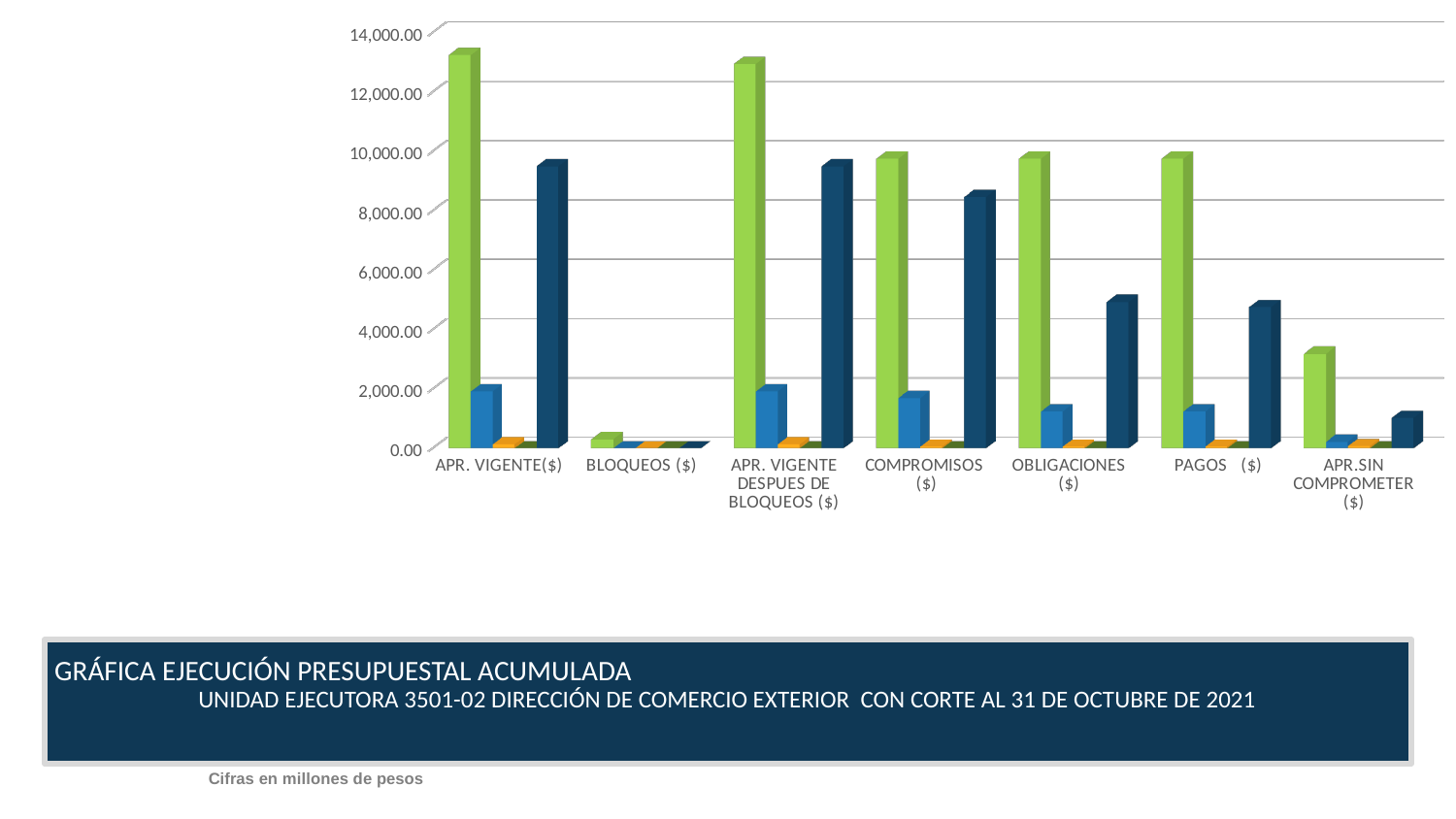
Which is larger, the light green bar for PAGOS ($) or the light green bar for APR.SIN COMPROMETER ($)? PAGOS ($) What kind of chart is shown on the slide? bar chart Is the dark navy bar for OBLIGACIONES ($) greater or less than 4,000.00? greater Which category has the shortest light green bar? BLOQUEOS ($) How many categories are shown on the x axis of the chart? 7 According to the note below the chart, in what units are the figures expressed? Cifras en millones de pesos Which is larger, the dark navy bar for COMPROMISOS ($) or the dark navy bar for OBLIGACIONES ($)? COMPROMISOS ($) Is the dark navy bar for APR. VIGENTE($) greater or less than 8,000.00? greater Is the light green bar for APR. VIGENTE($) greater or less than 12,000.00? greater Which category has the tallest light green bar? APR. VIGENTE($)